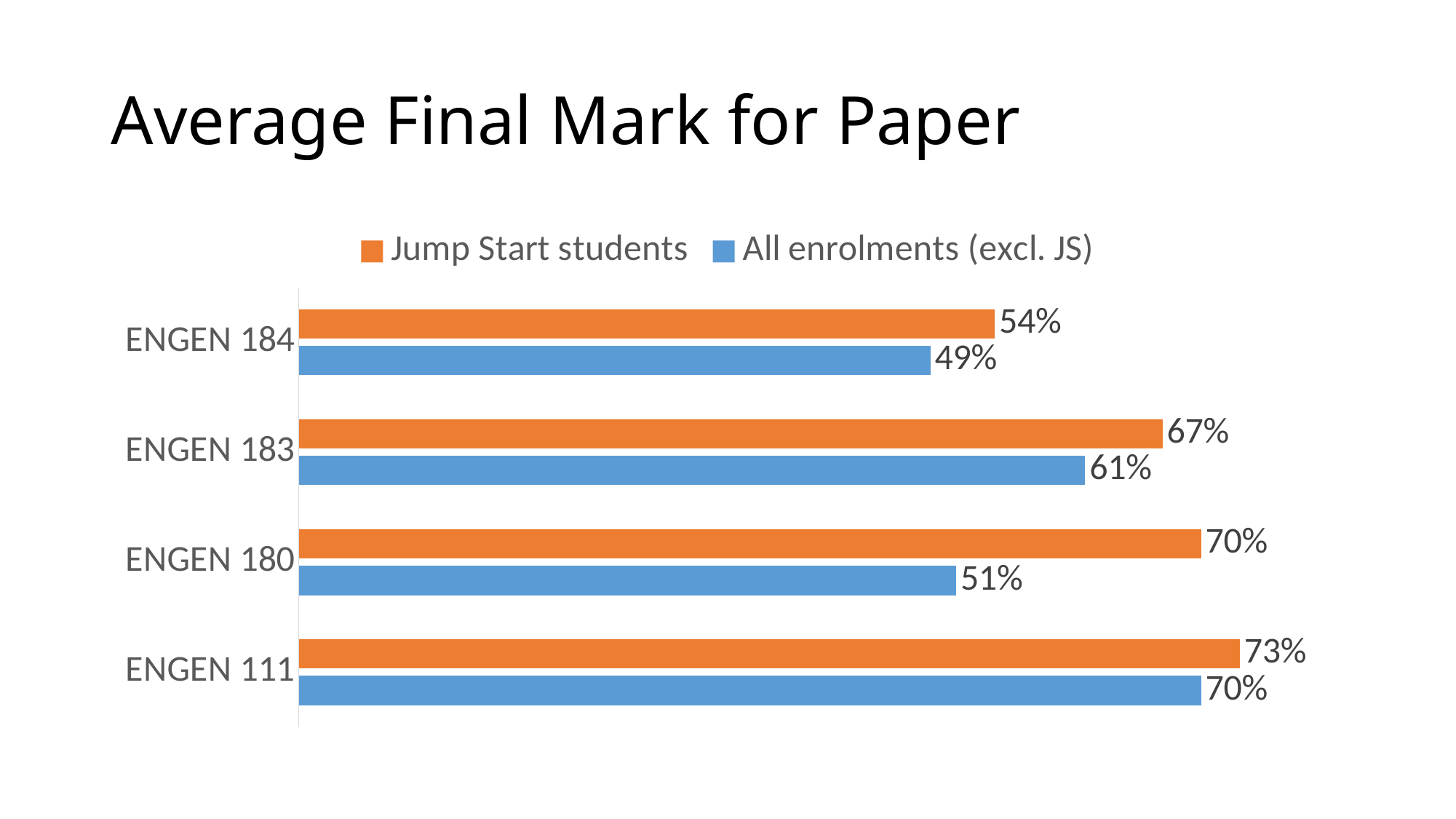
How many series does the legend list? 2 What is the average final mark for Jump Start students in ENGEN 184? 54% What is the difference between the Jump Start students mark and the All enrolments (excl. JS) mark for ENGEN 111? 3% What colour represents the All enrolments (excl. JS) series? Blue What is the difference between the Jump Start students mark and the All enrolments (excl. JS) mark for ENGEN 180? 19% What is the average final mark for All enrolments (excl. JS) in ENGEN 183? 61% How many papers are shown on the chart? 4 Which paper has the highest average final mark for Jump Start students? ENGEN 111 Which is larger for ENGEN 183: the Jump Start students mark or the All enrolments (excl. JS) mark? Jump Start students Which paper has the lowest average final mark for All enrolments (excl. JS)? ENGEN 184 What kind of chart is shown on the slide? Bar chart What is the average final mark for All enrolments (excl. JS) in ENGEN 180? 51%